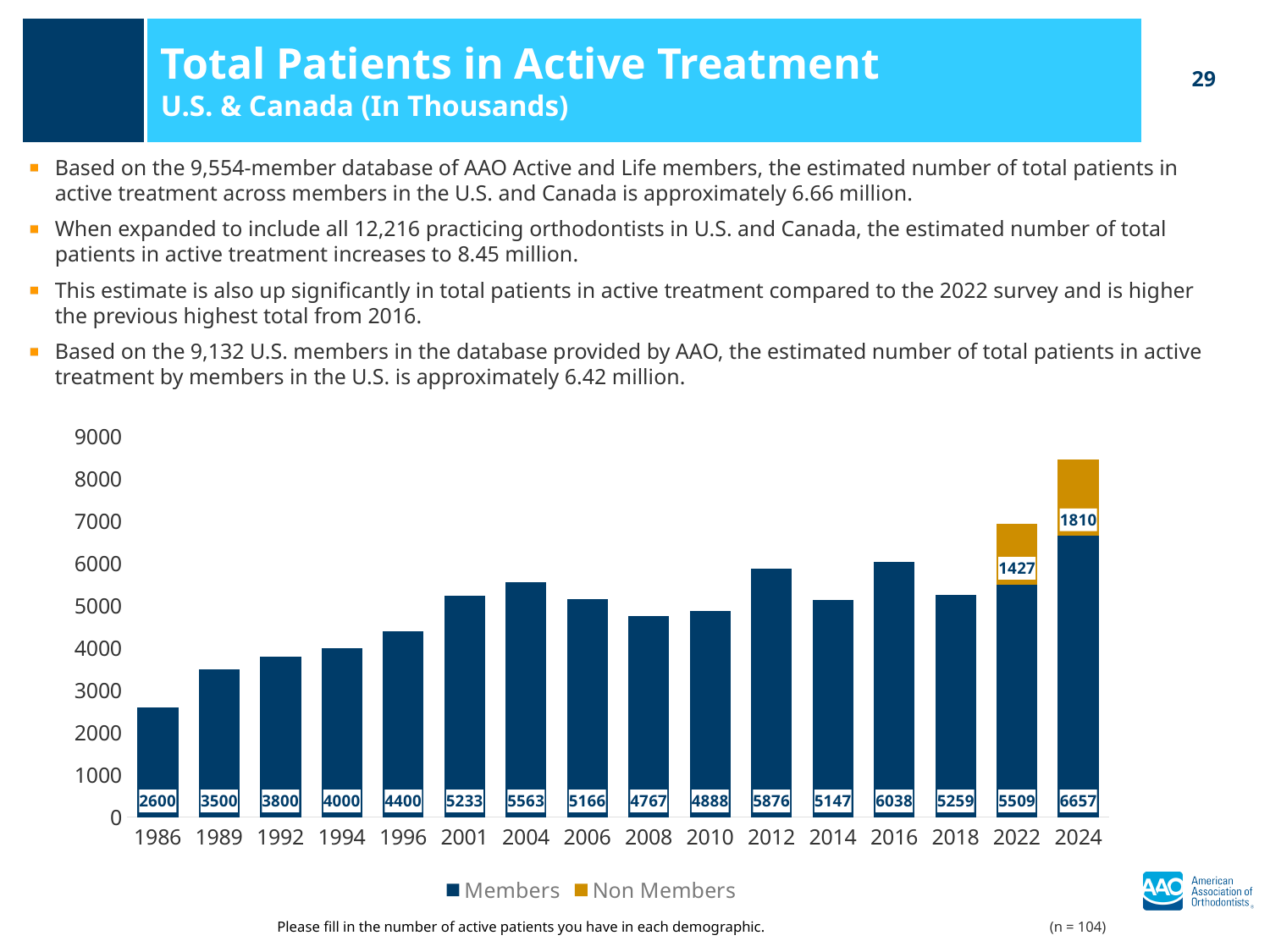
What is the Non Members value for 2022? 1427 Which year has the lowest Members value? 1986 What kind of chart is shown? Stacked bar chart How many years are shown on the x axis? 16 What is the difference between the Members values for 2024 and 2022? 1148 Which year has the highest Members value? 2024 What is the total of the stacked bar for 2022? 6936 What is the total of the stacked bar for 2024? 8467 What is the Members value for 1986? 2600 How many series does the legend list? 2 Which is larger, the Members value for 2016 or for 2012? 2016 What is the Members value for 2024? 6657